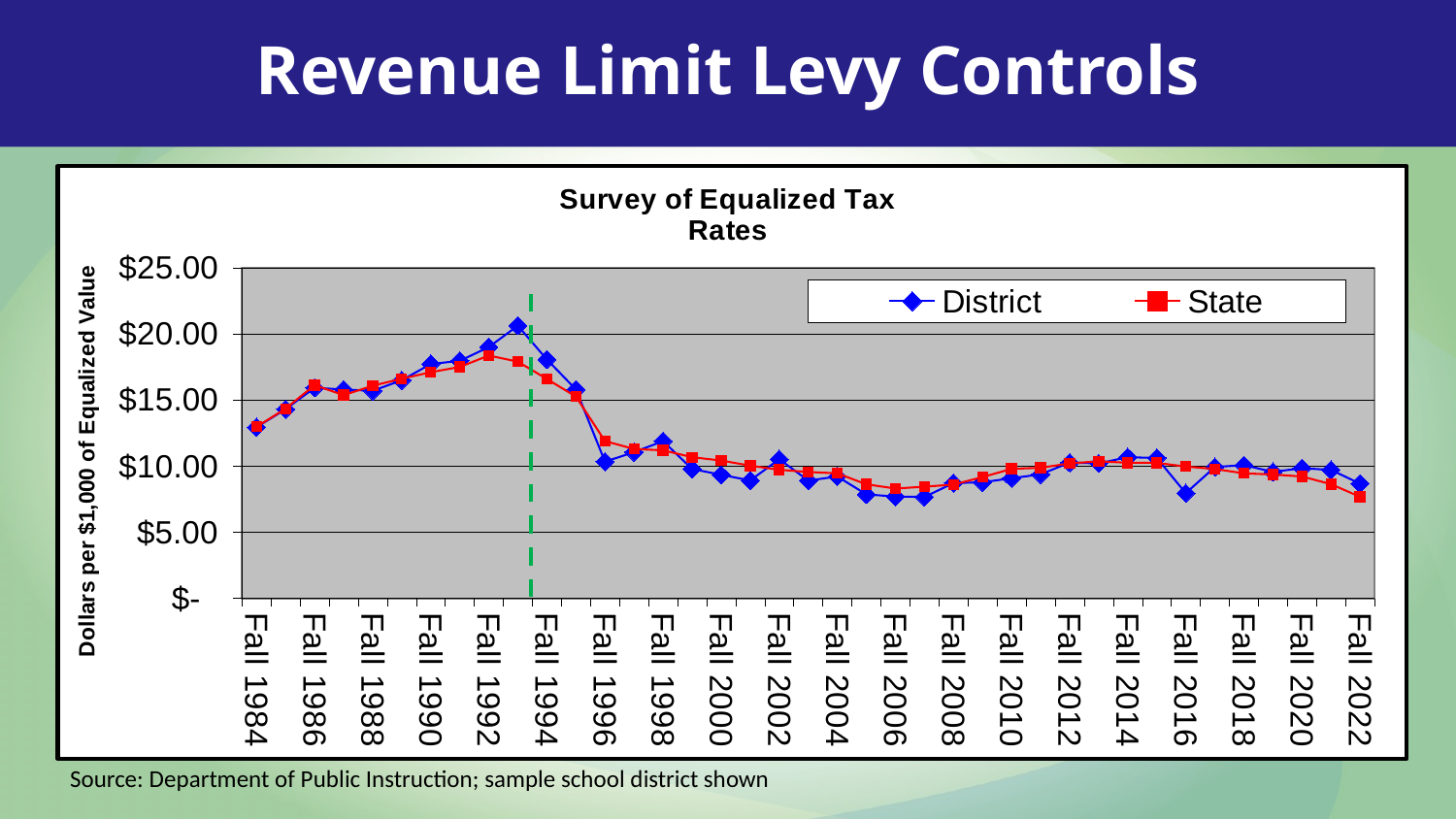
Is the District value for Fall 1984 greater or less than $15.00? less In Fall 2016, which series has the larger value, District or State? State Is the District value for Fall 1992 greater or less than $15.00? greater Is the State value for Fall 2022 greater or less than $10.00? less Do the District values rise or fall from Fall 1984 to Fall 1992? rise What is the title of the chart? Survey of Equalized Tax Rates What kind of chart is shown on the slide? Line chart What are the two series named in the legend? District and State How many series does the legend list? 2 In Fall 1996, which series has the larger value, District or State? State